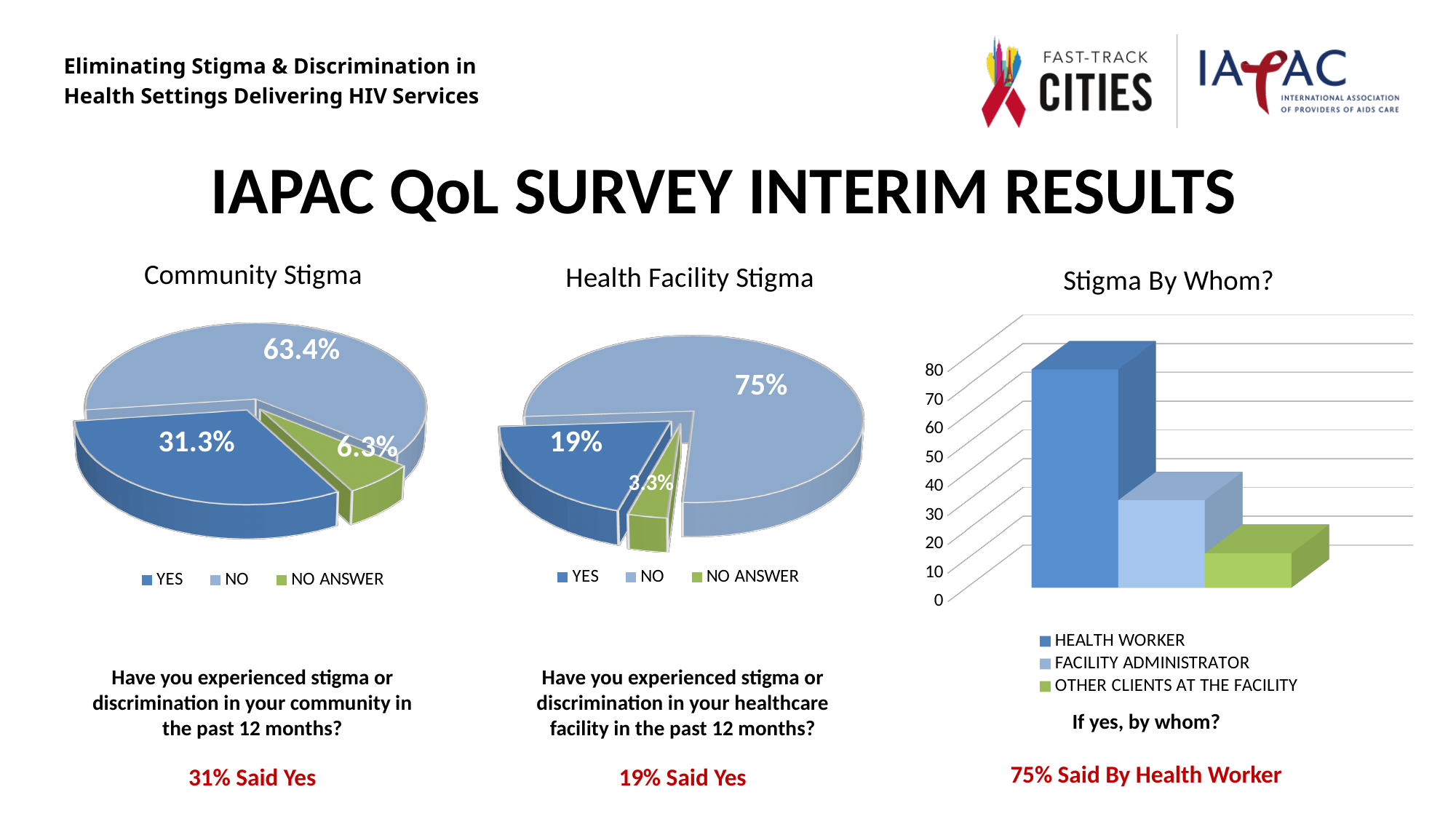
In the Health Facility Stigma pie chart, what percentage of respondents answered YES? 19% In the Community Stigma pie chart, what percentage of respondents answered YES? 31.3% In the Community Stigma pie chart, which response has the largest slice? NO In the Community Stigma pie chart, what percentage of respondents answered NO? 63.4% In the Health Facility Stigma pie chart, which response has the smallest slice? NO ANSWER What is the difference between the YES share in the Community Stigma chart and the YES share in the Health Facility Stigma chart? 12.3% What kind of chart is the Stigma By Whom? chart? Bar chart In the Health Facility Stigma pie chart, what percentage of respondents answered NO? 75% In the Community Stigma pie chart, what is the share for NO ANSWER? 6.3% In the Stigma By Whom? chart, is the value for FACILITY ADMINISTRATOR greater or less than 50? less How many categories does the legend of the Stigma By Whom? chart list? 3 In the Stigma By Whom? chart, which category has the highest bar? HEALTH WORKER